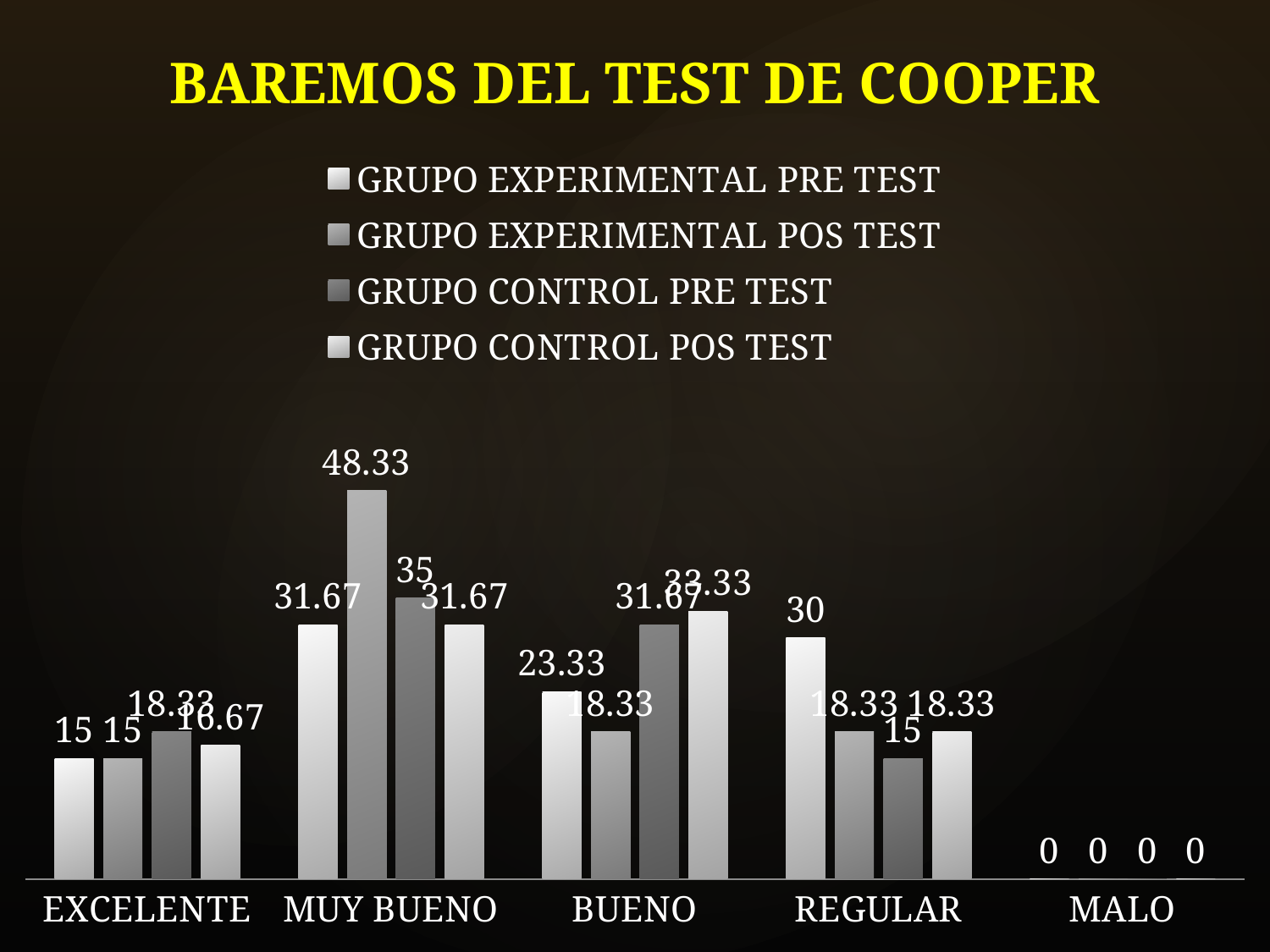
What is the value for GRUPO EXPERIMENTAL POS TEST in the MUY BUENO category? 48.33 What value do all four series have in the MALO category? 0 Which category and series has the highest value in the chart? MUY BUENO, GRUPO EXPERIMENTAL POS TEST In the BUENO category, which is larger: GRUPO EXPERIMENTAL PRE TEST or GRUPO EXPERIMENTAL POS TEST? GRUPO EXPERIMENTAL PRE TEST In the MUY BUENO category, what is the difference between GRUPO EXPERIMENTAL POS TEST and GRUPO EXPERIMENTAL PRE TEST? 16.66 How many series does the legend list? 4 What kind of chart is shown on the slide? bar chart What is the title of the chart? BAREMOS DEL TEST DE COOPER What is the value for GRUPO CONTROL PRE TEST in the MUY BUENO category? 35 What is the value for GRUPO EXPERIMENTAL PRE TEST in the BUENO category? 23.33 What is the value for GRUPO EXPERIMENTAL PRE TEST in the REGULAR category? 30 How many categories are shown on the x axis? 5